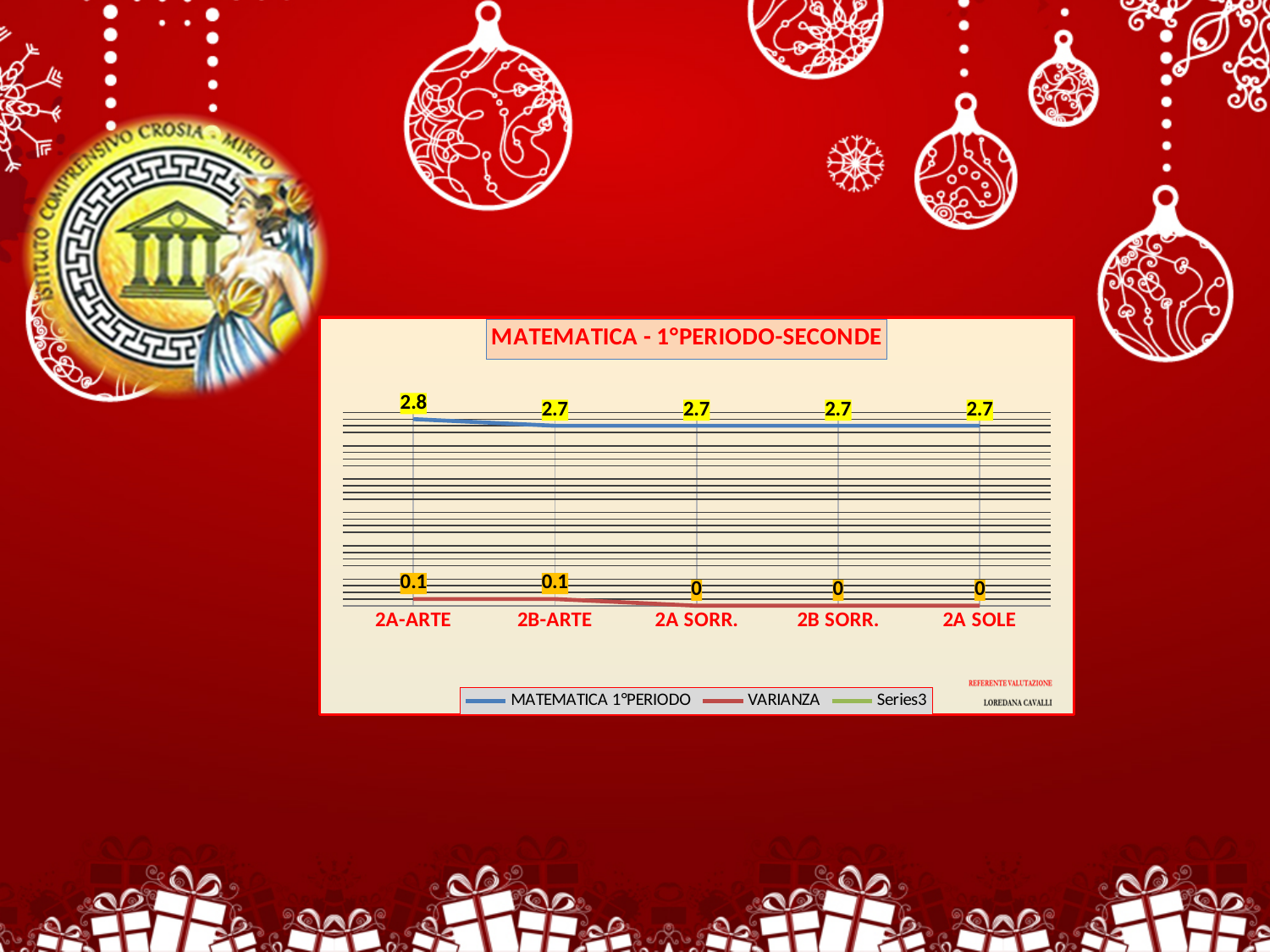
Which category has the highest MATEMATICA 1°PERIODO value? 2A-ARTE How many series does the legend list? 3 What is the MATEMATICA 1°PERIODO value for 2B SORR.? 2.7 What is the VARIANZA value for 2A SOLE? 0 What kind of chart is shown on the slide? Line chart What is the difference between the MATEMATICA 1°PERIODO values for 2A-ARTE and 2B-ARTE? 0.1 What is the title of the chart? MATEMATICA - 1°PERIODO-SECONDE Is the MATEMATICA 1°PERIODO value for 2A SORR. larger than the VARIANZA value for 2A SORR.? Yes What is the MATEMATICA 1°PERIODO value for 2A-ARTE? 2.8 What is the VARIANZA value for 2B-ARTE? 0.1 How many categories are shown on the x axis? 5 Does the VARIANZA series rise or fall from 2B-ARTE to 2A SORR.? Fall